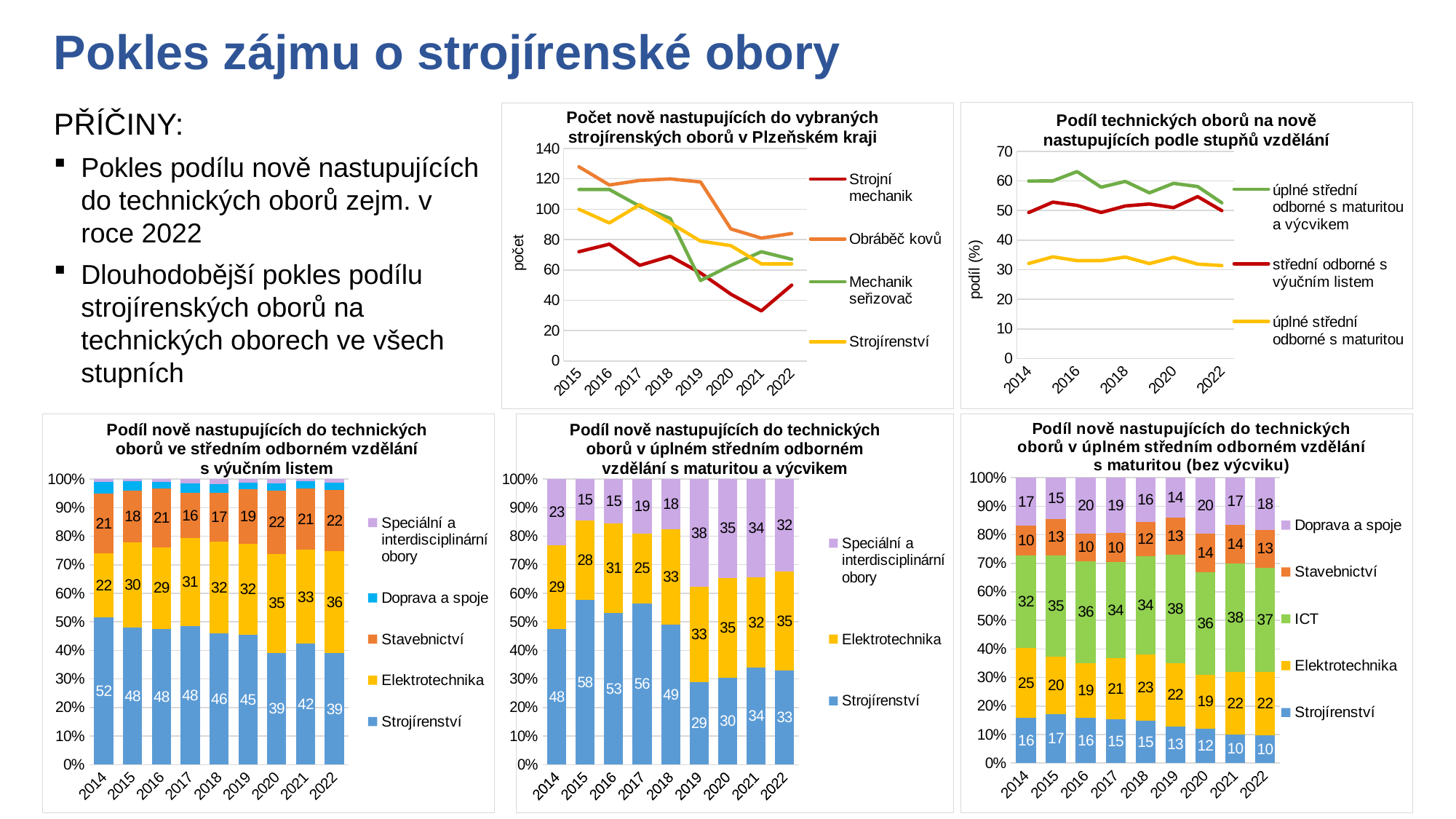
In the chart 'Počet nově nastupujících do vybraných strojírenských oborů v Plzeňském kraji', how many series does the legend list? 4 In the bottom-left chart 'Podíl nově nastupujících do technických oborů ve středním odborném vzdělání s výučním listem', what is the value for Strojírenství in 2014? 52 In the chart 'Počet nově nastupujících do vybraných strojírenských oborů v Plzeňském kraji', is the value for Obráběč kovů in 2015 greater or less than 120? greater In the bottom-right chart 'Podíl nově nastupujících do technických oborů v úplném středním odborném vzdělání s maturitou (bez výcviku)', how many series does the legend list? 5 In the bottom-left chart 'Podíl nově nastupujících do technických oborů ve středním odborném vzdělání s výučním listem', what is the difference between the Elektrotechnika values in 2022 and 2014? 14 In the bottom-middle chart 'Podíl nově nastupujících do technických oborů v úplném středním odborném vzdělání s maturitou a výcvikem', what is the value for Speciální a interdisciplinární obory in 2019? 38 In the bottom-middle chart 'Podíl nově nastupujících do technických oborů v úplném středním odborném vzdělání s maturitou a výcvikem', in which year is the Strojírenství value highest? 2015 In the chart 'Podíl technických oborů na nově nastupujících podle stupňů vzdělání', which series has the lowest values across all years? úplné střední odborné s maturitou In the chart 'Podíl technických oborů na nově nastupujících podle stupňů vzdělání', is the value for 'úplné střední odborné s maturitou a výcvikem' in 2016 greater or less than 60? greater In the chart 'Počet nově nastupujících do vybraných strojírenských oborů v Plzeňském kraji', is the value for Strojní mechanik in 2021 greater or less than 40? less What kind of chart is 'Počet nově nastupujících do vybraných strojírenských oborů v Plzeňském kraji'? line chart In the bottom-right chart 'Podíl nově nastupujících do technických oborů v úplném středním odborném vzdělání s maturitou (bez výcviku)', which is larger in 2019: ICT or Elektrotechnika? ICT